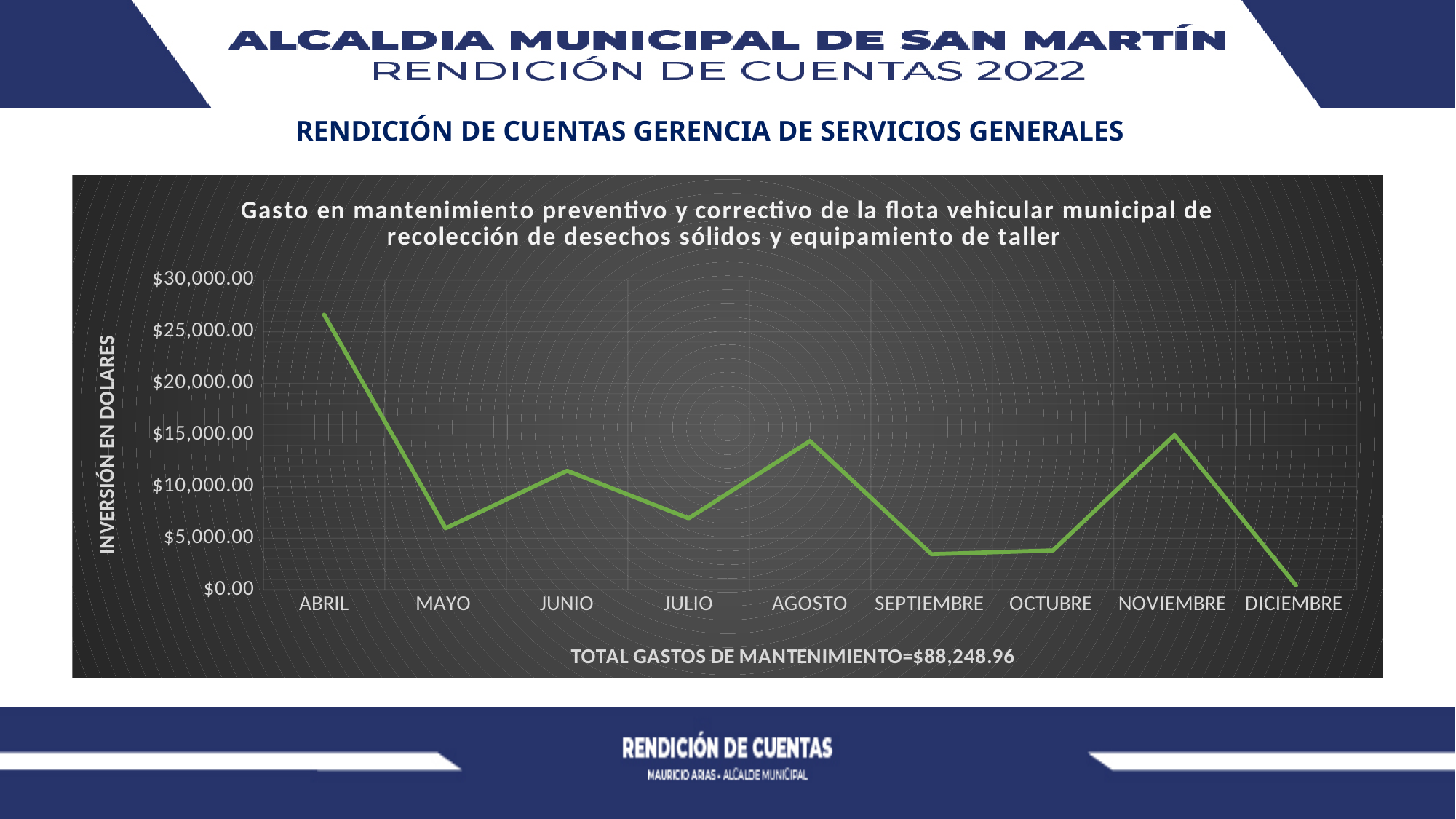
Which month has the highest maintenance expense in the chart? ABRIL How many months are plotted on the x axis of the chart? 9 Is the value for JUNIO greater or less than $10,000.00? greater Which month has a higher value, NOVIEMBRE or OCTUBRE? NOVIEMBRE Is the value for MAYO greater or less than $10,000.00? less What total maintenance expense is printed below the chart? $88,248.96 Is the value for SEPTIEMBRE greater or less than $5,000.00? less Does the line rise or fall from NOVIEMBRE to DICIEMBRE? fall Which month has the lowest maintenance expense in the chart? DICIEMBRE Which month has a higher value, JUNIO or JULIO? JUNIO What kind of chart is shown on the slide? line chart